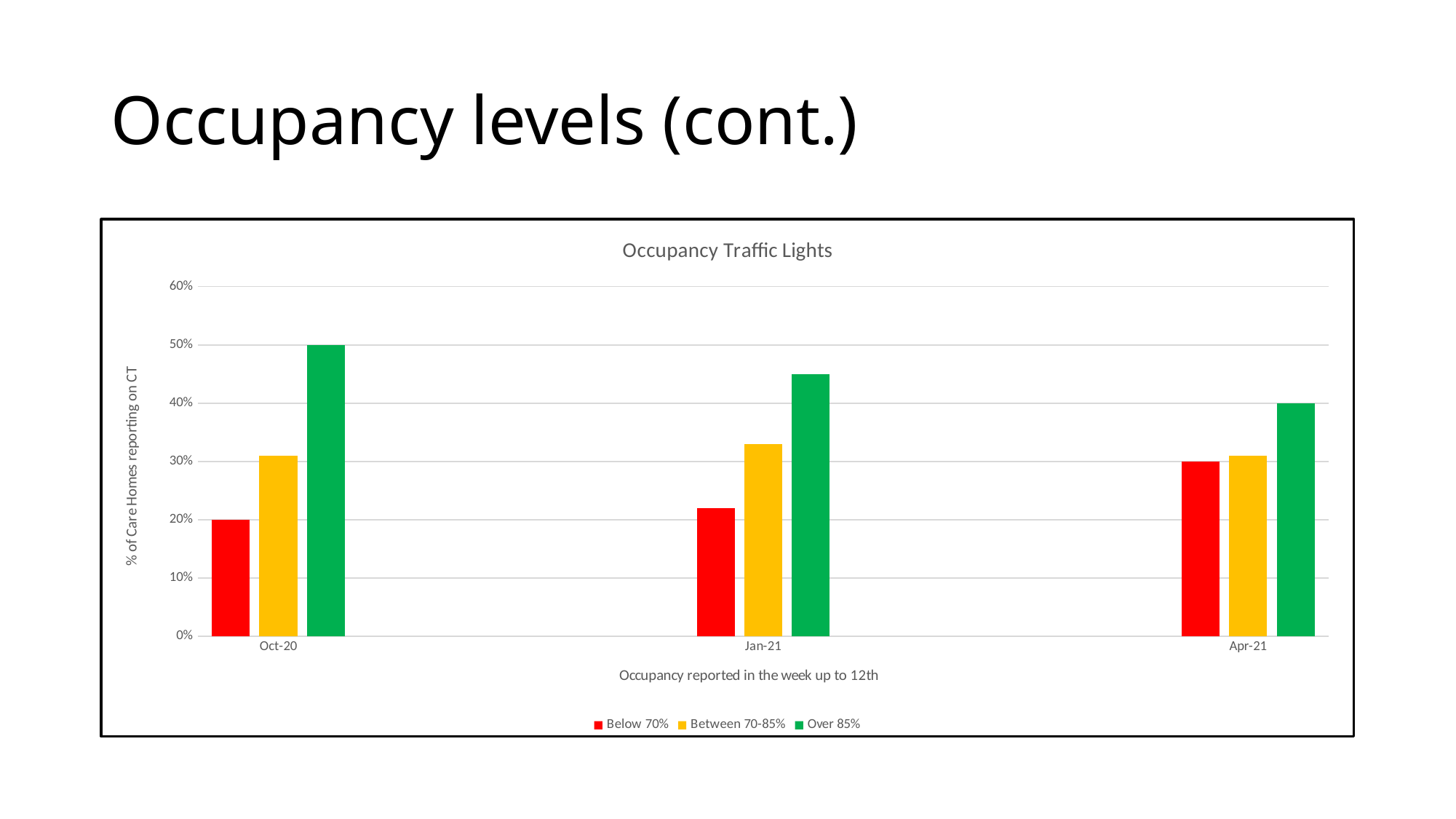
What is the value for Over 85% in Oct-20? 50% What is the title of the chart? Occupancy Traffic Lights In which period is the Over 85% series highest? Oct-20 Is the value for Over 85% in Jan-21 greater or less than 40%? greater How many series does the legend list? 3 What is the value for Over 85% in Apr-21? 40% What is the value for Below 70% in Apr-21? 30% In which period is the Below 70% series lowest? Oct-20 What is the value for Below 70% in Oct-20? 20% What type of chart is shown on the slide? Bar chart How many time periods are shown on the x axis? 3 Does the Over 85% series rise or fall from Oct-20 to Apr-21? Fall